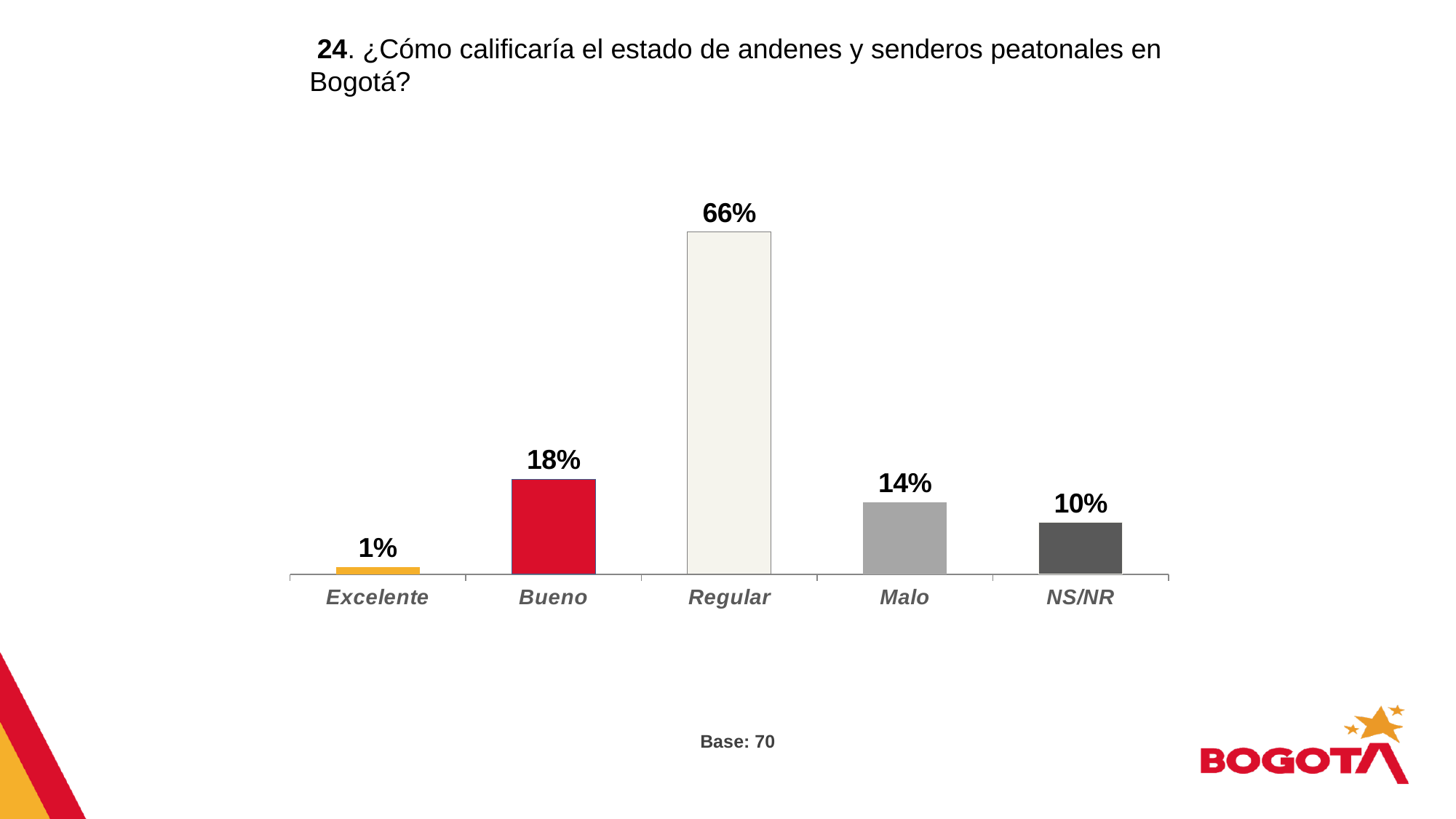
What is the base (sample size) stated below the chart? 70 Which category has the highest value? Regular What is the difference between the values for Regular and Bueno? 48% Which category has the lowest value? Excelente Which is larger, the value for Bueno or the value for Malo? Bueno What is the difference between the values for Malo and NS/NR? 4% What is the value for Regular? 66% How many categories are shown on the x axis? 5 What is the value for Bueno? 18% What is the value for Excelente? 1% What is the value for NS/NR? 10% What kind of chart is shown on the slide? Bar chart